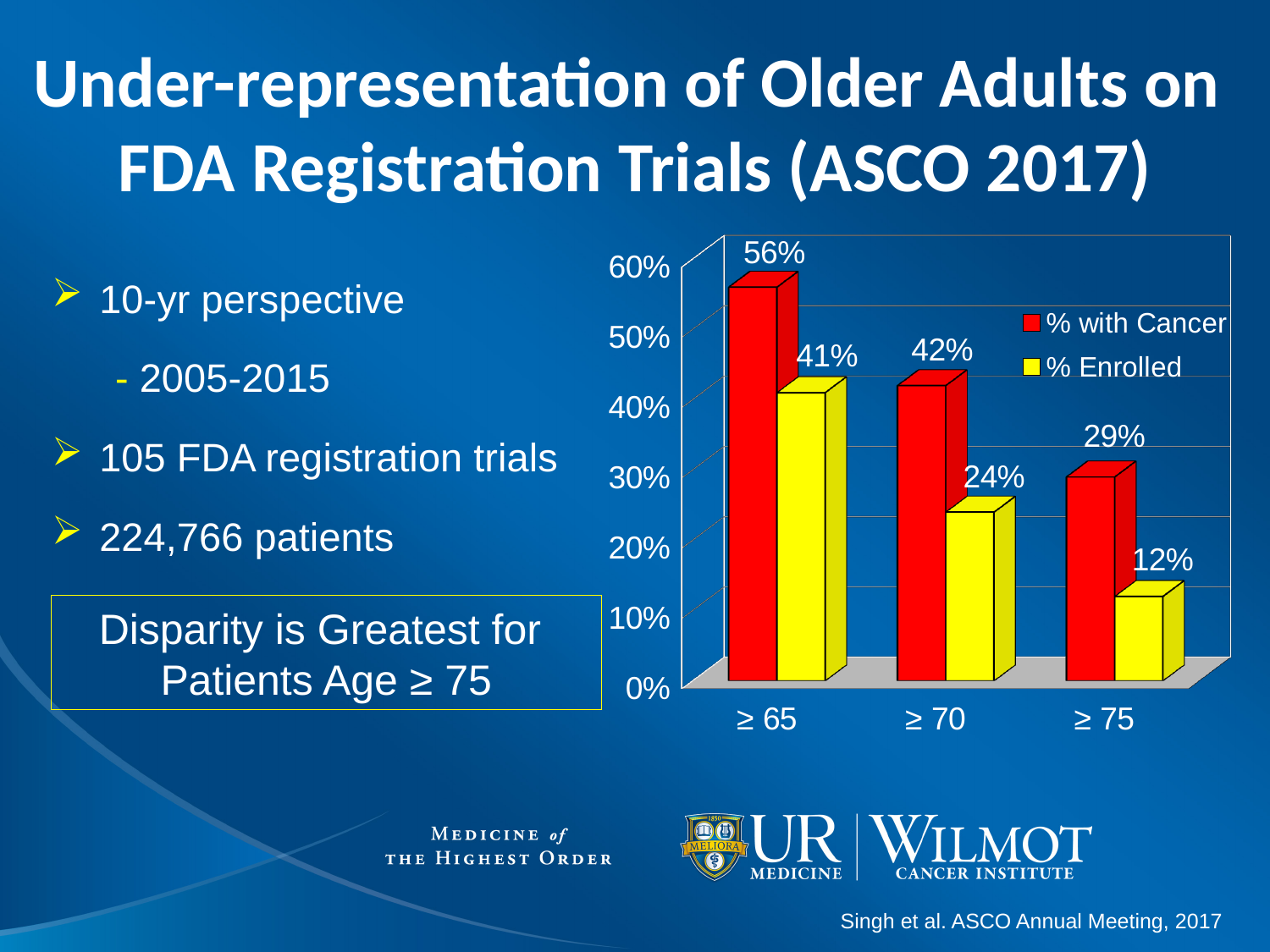
What is the difference between % with Cancer and % Enrolled for the ≥ 75 age group? 17% What is the % with Cancer value for the ≥ 65 age group? 56% How many series does the chart legend list? 2 Which is larger for the ≥ 70 age group: % with Cancer or % Enrolled? % with Cancer Which age group has the highest % with Cancer value? ≥ 65 What is the % Enrolled value for the ≥ 70 age group? 24% What kind of chart is shown on the slide? Bar chart What is the % Enrolled value for the ≥ 75 age group? 12% What is the difference between % with Cancer and % Enrolled for the ≥ 65 age group? 15% Which age group has the lowest % Enrolled value? ≥ 75 How many age groups are shown on the x axis of the chart? 3 Do the % Enrolled values rise or fall from ≥ 65 to ≥ 75? Fall